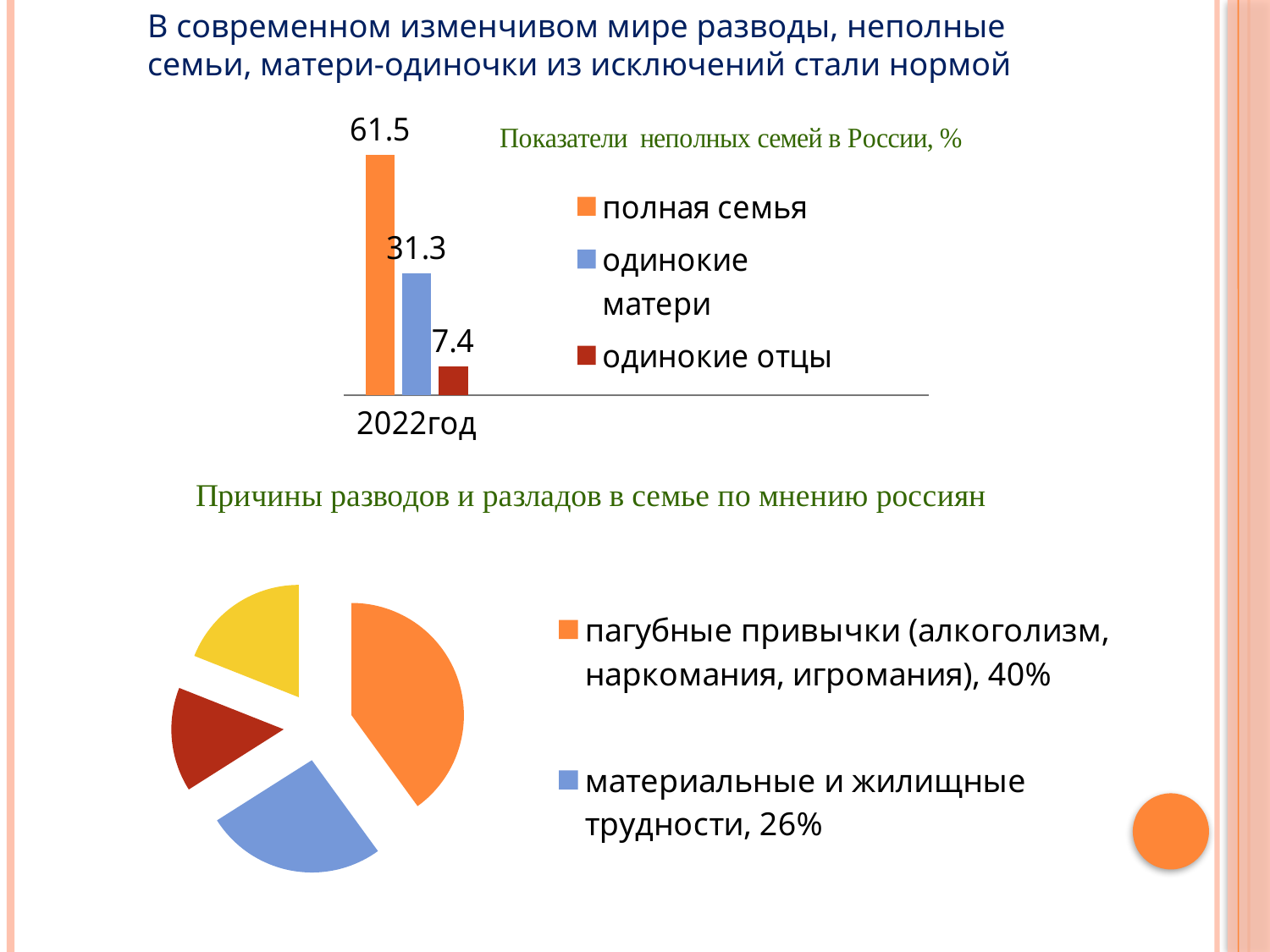
How many series does the legend of the chart 'Показатели неполных семей в России, %' list? 3 In the chart 'Показатели неполных семей в России, %', what is the value for 'полная семья'? 61.5 In the chart 'Показатели неполных семей в России, %', what is the value for 'одинокие отцы'? 7.4 In the chart 'Показатели неполных семей в России, %', which series has the lowest value? одинокие отцы In the chart 'Показатели неполных семей в России, %', which series has the highest value? полная семья What kind of chart is 'Показатели неполных семей в России, %'? bar chart What year is shown on the x axis of the chart 'Показатели неполных семей в России, %'? 2022год In the chart 'Причины разводов и разладов в семье по мнению россиян', what share is given for 'материальные и жилищные трудности'? 26% In the chart 'Показатели неполных семей в России, %', what is the difference between the values for 'полная семья' and 'одинокие матери'? 30.2 In the chart 'Причины разводов и разладов в семье по мнению россиян', what share is given for 'пагубные привычки (алкоголизм, наркомания, игромания)'? 40% In the chart 'Показатели неполных семей в России, %', what is the value for 'одинокие матери'? 31.3 In the chart 'Показатели неполных семей в России, %', which is larger: 'одинокие матери' or 'одинокие отцы'? одинокие матери